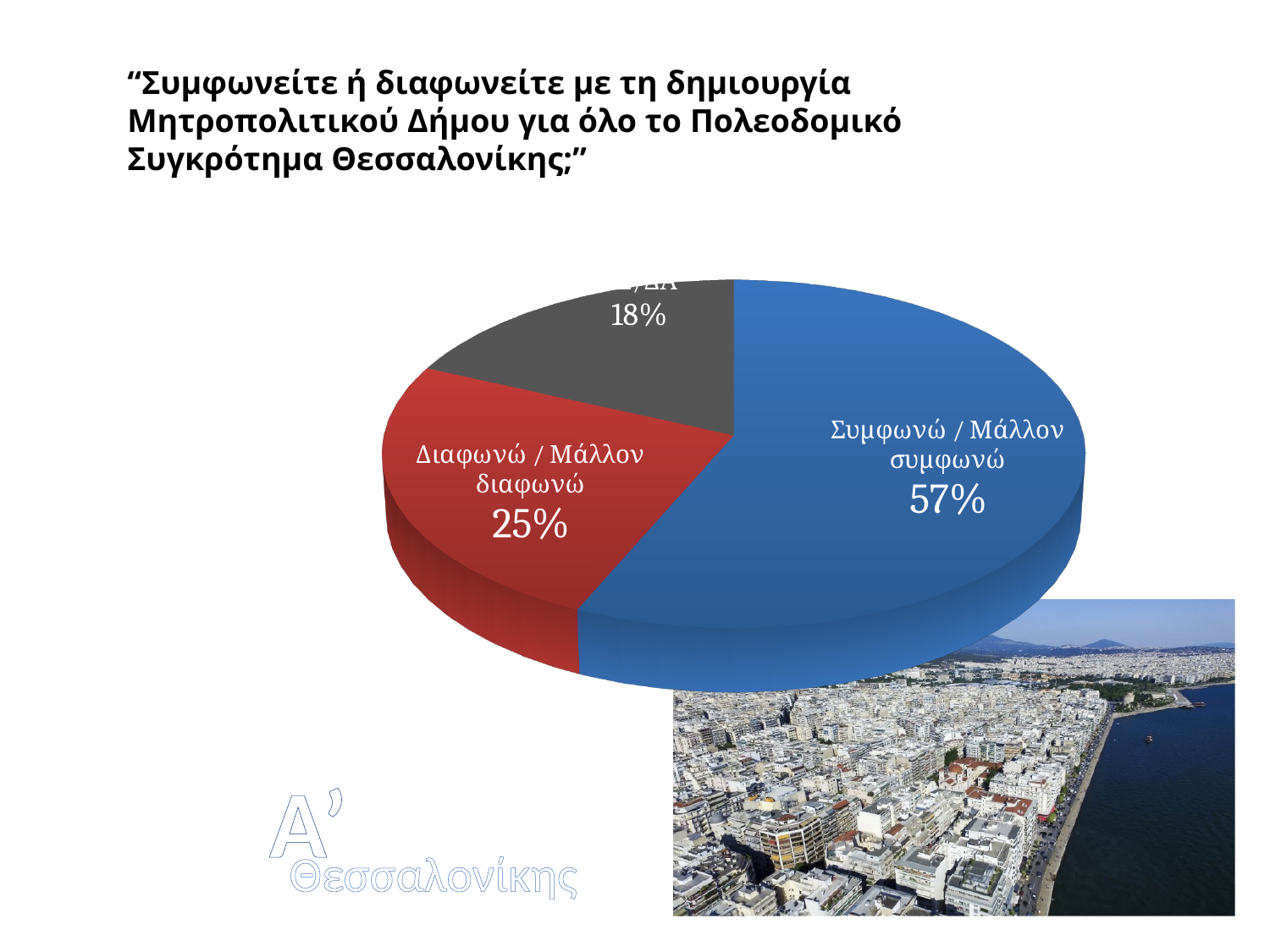
What percentage of respondents answered "Συμφωνώ / Μάλλον συμφωνώ"? 57% What percentage of respondents answered "Διαφωνώ / Μάλλον διαφωνώ"? 25% What is the smallest percentage shown on the pie chart? 18% How many slices does the pie chart have? 3 What share of the pie does "Συμφωνώ / Μάλλον συμφωνώ" represent? 57% Which response category has the largest share of the pie? Συμφωνώ / Μάλλον συμφωνώ What colour is the "Διαφωνώ / Μάλλον διαφωνώ" slice? red What kind of chart is shown on the slide? pie chart Which is larger: the share for "Συμφωνώ / Μάλλον συμφωνώ" or for "Διαφωνώ / Μάλλον διαφωνώ"? Συμφωνώ / Μάλλον συμφωνώ What is the combined percentage of "Συμφωνώ / Μάλλον συμφωνώ" and "Διαφωνώ / Μάλλον διαφωνώ"? 82% Is the share for "Συμφωνώ / Μάλλον συμφωνώ" greater or less than 50%? greater By how many percentage points does "Συμφωνώ / Μάλλον συμφωνώ" exceed "Διαφωνώ / Μάλλον διαφωνώ"? 32 percentage points